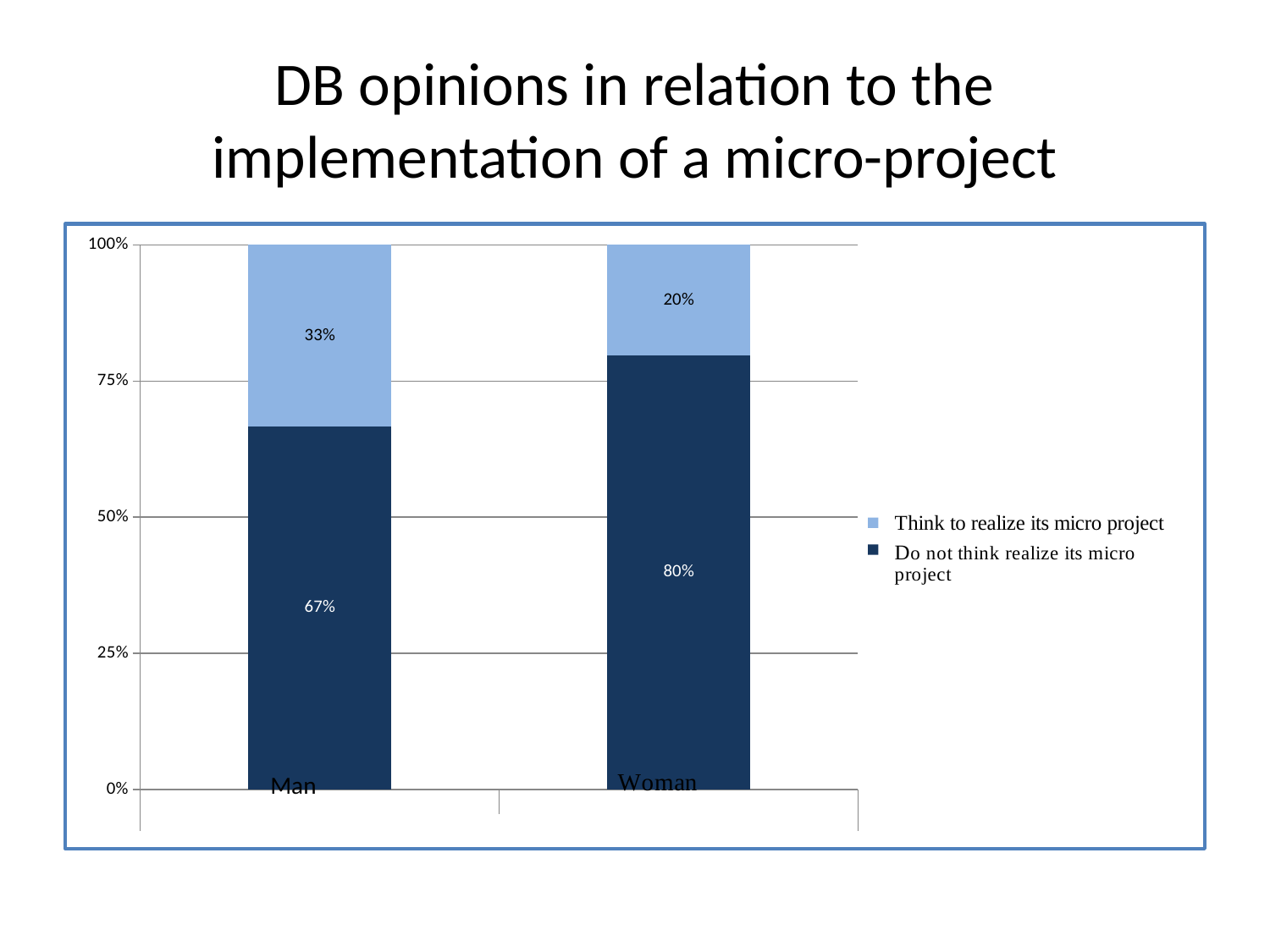
How many categories are shown on the x axis? 2 What percentage of women think to realize their micro project? 20% What percentage of women do not think to realize their micro project? 80% Which category has the higher share for 'Do not think realize its micro project', Man or Woman? Woman What percentage of men do not think to realize their micro project? 67% What kind of chart is shown on the slide? Stacked bar chart Which category has the lower share for 'Think to realize its micro project'? Woman How many series does the legend list? 2 Which series is shown in the darker blue colour? Do not think realize its micro project What is the difference between the 'Do not think realize its micro project' shares for Woman and Man? 13% What is the difference between the 'Think to realize its micro project' shares for Man and Woman? 13% What percentage of men think to realize their micro project? 33%